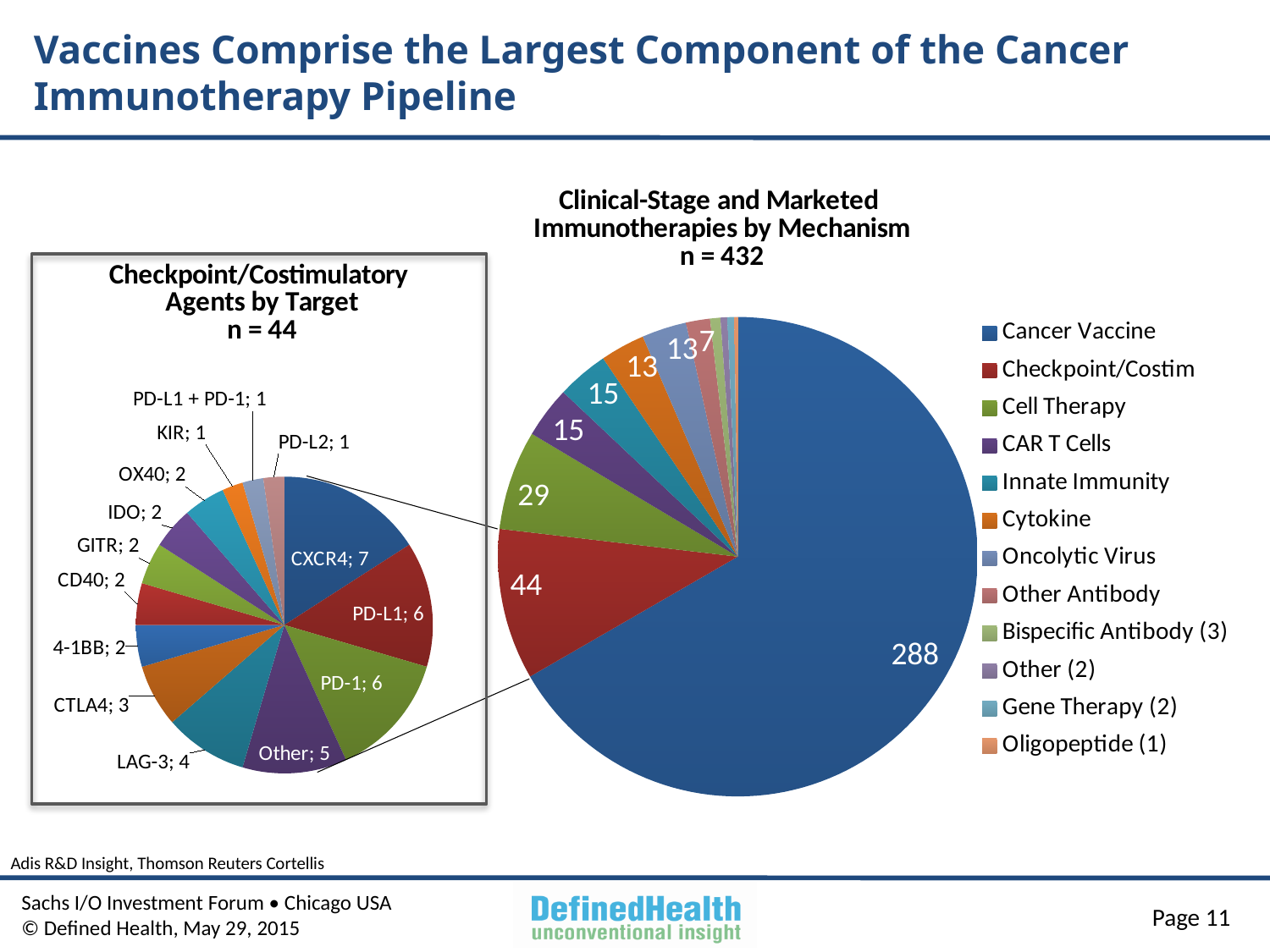
In the 'Clinical-Stage and Marketed Immunotherapies by Mechanism' pie chart, what is the value for Cell Therapy? 29 In the 'Checkpoint/Costimulatory Agents by Target' pie chart, which target has the most agents? CXCR4 In the 'Clinical-Stage and Marketed Immunotherapies by Mechanism' pie chart, how many mechanism categories does the legend list? 12 In the 'Clinical-Stage and Marketed Immunotherapies by Mechanism' pie chart, what share of the 432 immunotherapies are Checkpoint/Costim agents, to the nearest whole percent? 10% In the 'Clinical-Stage and Marketed Immunotherapies by Mechanism' pie chart, what is the difference between the Cancer Vaccine and Checkpoint/Costim values? 244 In the 'Clinical-Stage and Marketed Immunotherapies by Mechanism' pie chart, how many immunotherapies are Cancer Vaccines? 288 In the 'Checkpoint/Costimulatory Agents by Target' pie chart, what is the difference between the PD-L1 and PD-L2 values? 5 In the 'Clinical-Stage and Marketed Immunotherapies by Mechanism' pie chart, which mechanism has the smallest slice? Oligopeptide In the 'Clinical-Stage and Marketed Immunotherapies by Mechanism' pie chart, which mechanism has the largest slice? Cancer Vaccine In the 'Checkpoint/Costimulatory Agents by Target' pie chart, how many agents target CXCR4? 7 What type of chart is used for the 'Checkpoint/Costimulatory Agents by Target' data? Pie chart In the 'Checkpoint/Costimulatory Agents by Target' pie chart, which is larger, LAG-3 or CTLA4? LAG-3